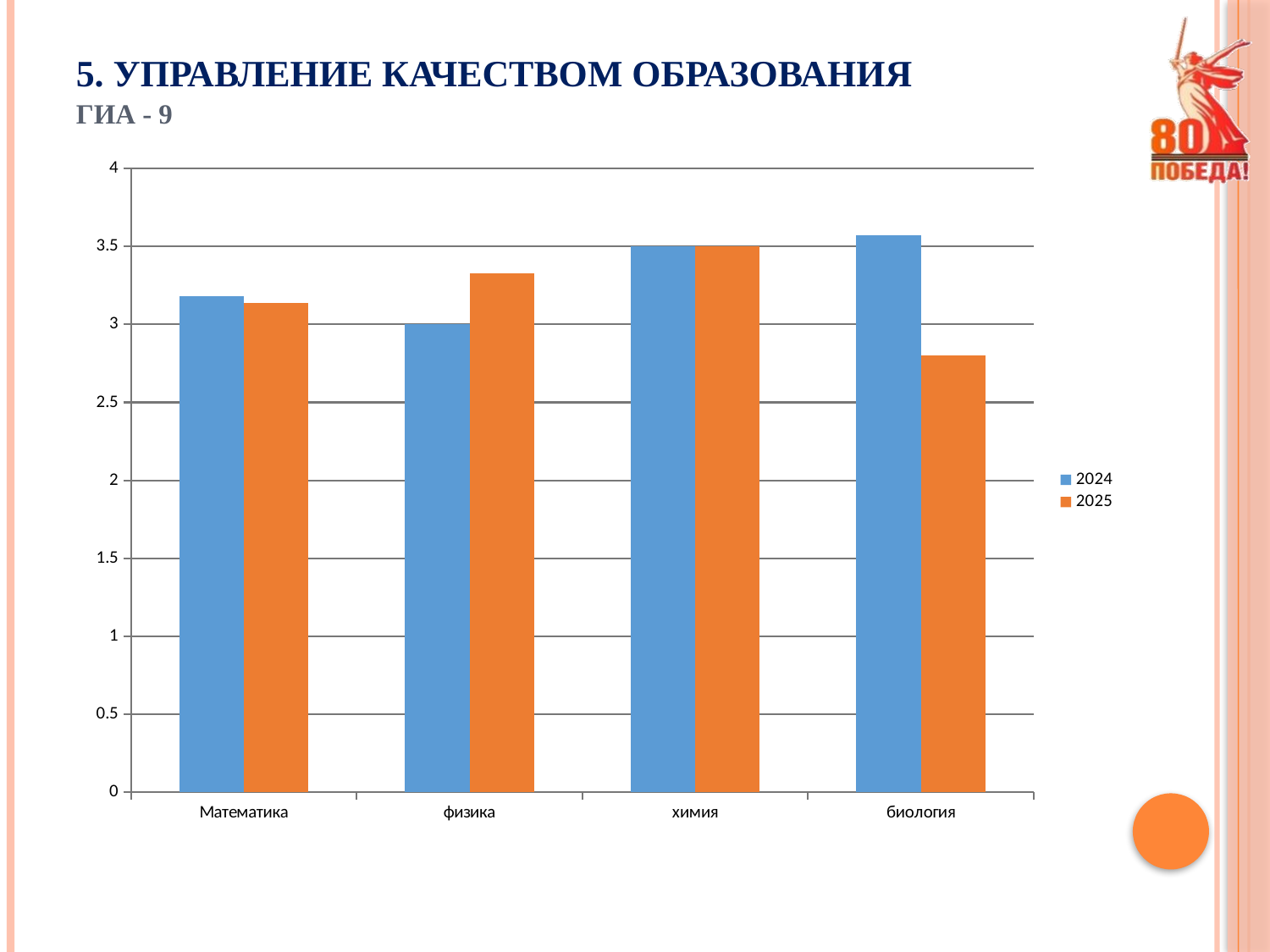
For физика, which series has the larger value, 2024 or 2025? 2025 Is the value for Математика in the 2024 series greater or less than 3? greater What are the two series named in the chart legend? 2024 and 2025 Is the value for биология in the 2025 series greater or less than 3? less Which subject has the lowest value in the 2025 series? биология What is the value for физика in the 2024 series? 3 Which subject has the highest value in the 2024 series? биология What is the value for химия in the 2025 series? 3.5 How many series does the chart legend list? 2 What kind of chart is shown on the slide? bar chart For биология, which series has the larger value, 2024 or 2025? 2024 How many subject categories are shown on the x axis of the chart? 4